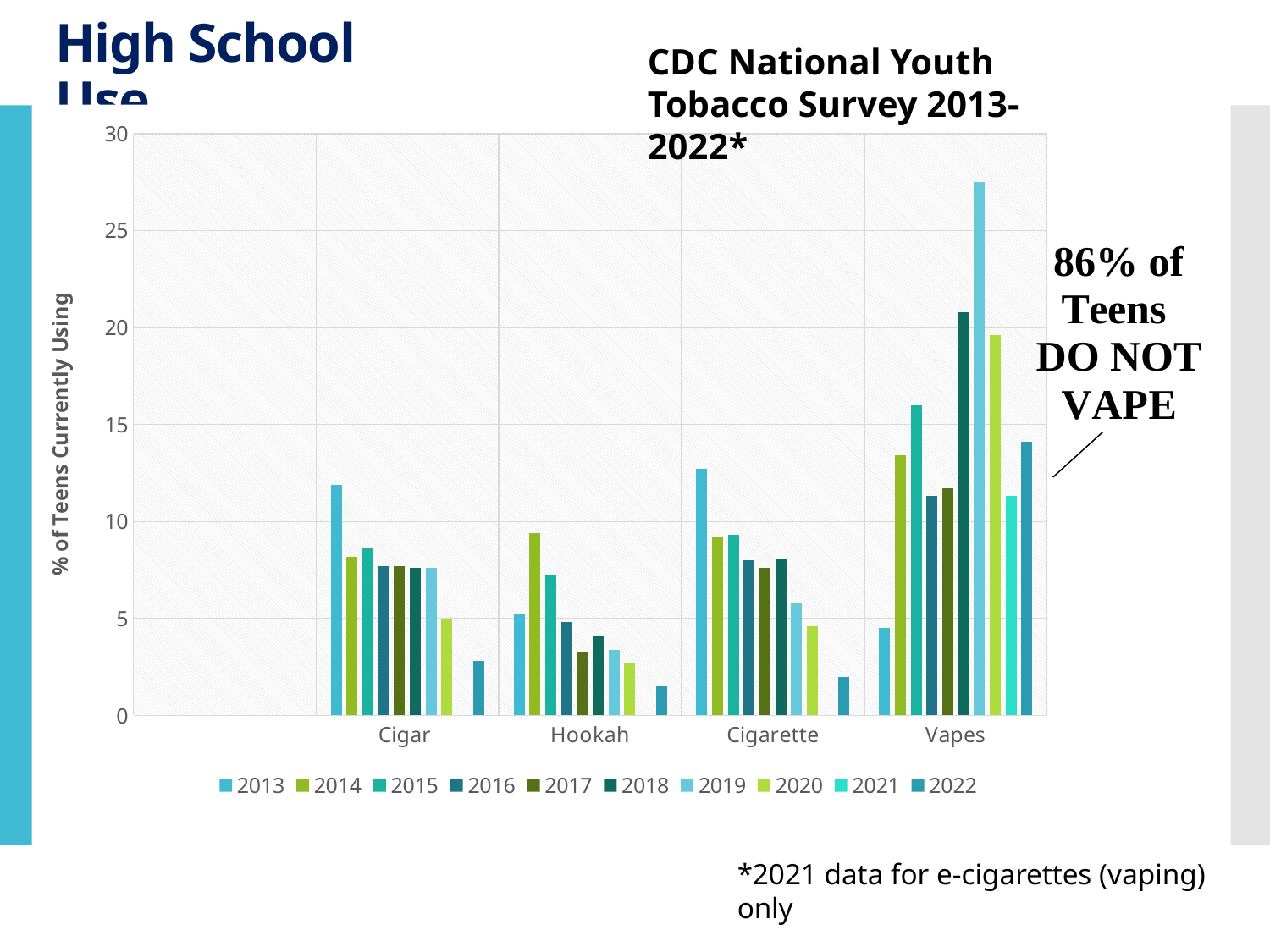
Which category has the lowest 2013 value? Vapes Do the Cigarette values generally rise or fall from 2013 to 2022? fall Is the 2022 value for Hookah greater or less than 5? less What kind of chart is shown on the slide? bar chart Which category has the highest 2019 value? Vapes How many product categories are shown on the x axis? 4 How many series (years) does the legend list? 10 What is the title of the vertical axis? % of Teens Currently Using Is the 2019 value for Vapes greater or less than 25? greater Is the 2018 value for Vapes greater or less than 15? greater Which is larger, the 2013 value for Cigar or the 2013 value for Hookah? Cigar